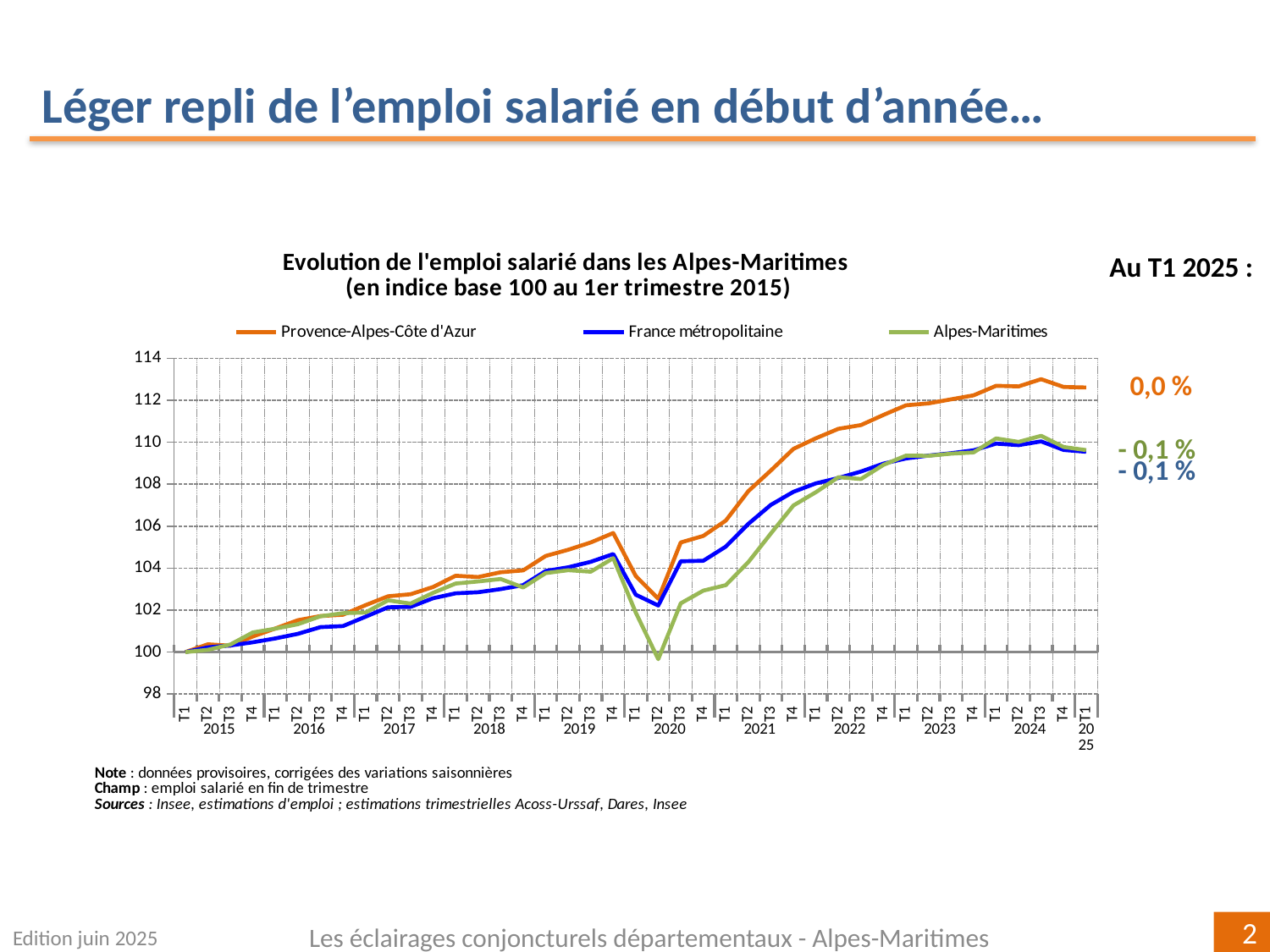
How many series does the legend list? 3 Which series has the lowest value at T2 2020? Alpes-Maritimes Which series is drawn in orange? Provence-Alpes-Côte d'Azur Is the value for Alpes-Maritimes at T2 2020 greater or less than 102? less Is the value for Provence-Alpes-Côte d'Azur at T1 2025 greater or less than 112? greater Overall, do the series rise or fall between T1 2015 and T1 2024? rise Is the value for France métropolitaine at T1 2025 greater or less than 110? less What is the title of the chart? Evolution de l'emploi salarié dans les Alpes-Maritimes (en indice base 100 au 1er trimestre 2015) What change is annotated for Provence-Alpes-Côte d'Azur at T1 2025? 0,0 % At T4 2019, which is higher: Provence-Alpes-Côte d'Azur or France métropolitaine? Provence-Alpes-Côte d'Azur Which series has the highest value at T1 2025? Provence-Alpes-Côte d'Azur What kind of chart is shown on the slide? line chart